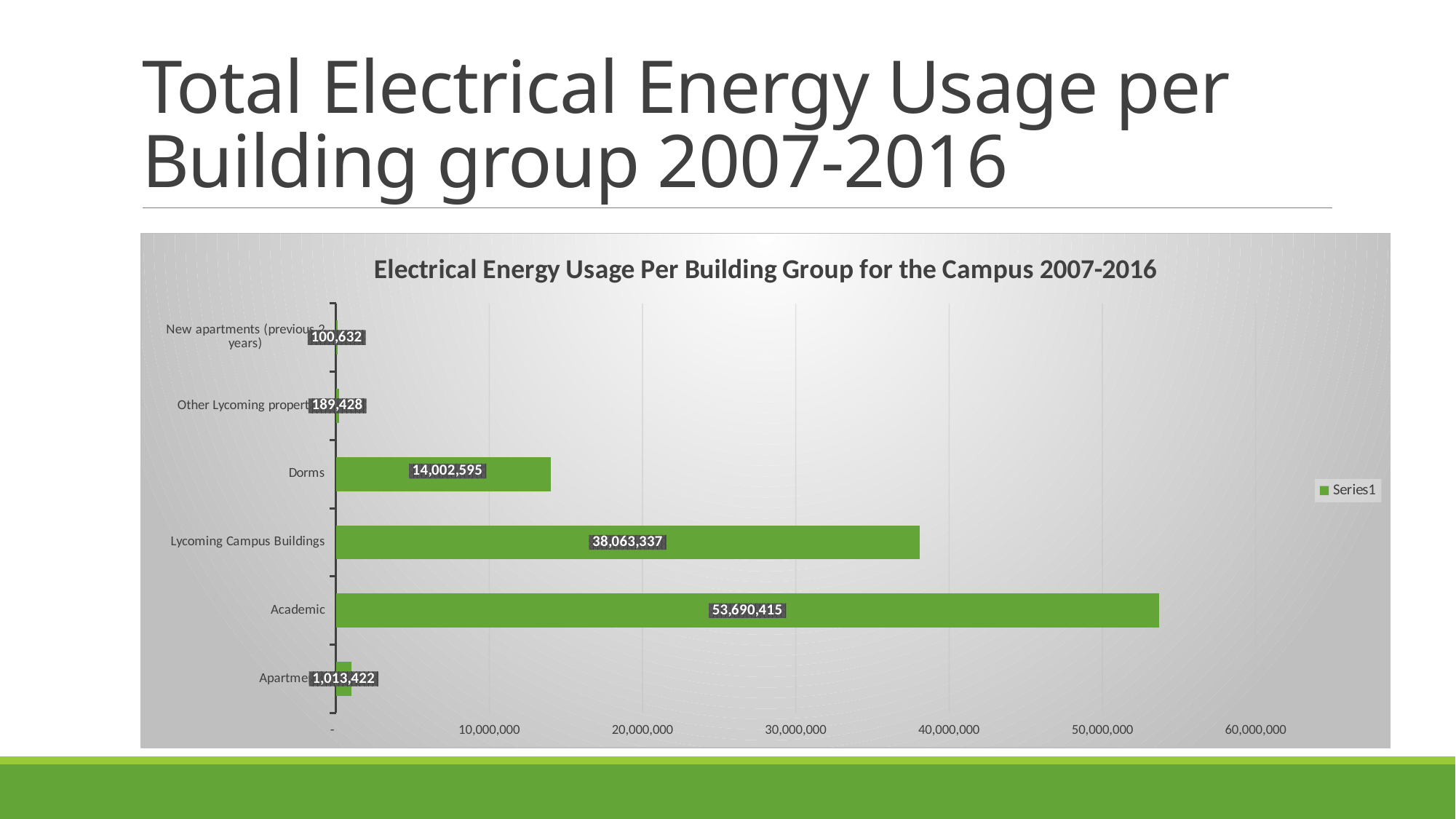
What is the title of the chart? Electrical Energy Usage Per Building Group for the Campus 2007-2016 What is the electrical energy usage value for Lycoming Campus Buildings? 38,063,337 What is the electrical energy usage value for Academic? 53,690,415 What is the electrical energy usage value for Dorms? 14,002,595 What is the difference in electrical energy usage between Lycoming Campus Buildings and Dorms? 24,060,742 What type of chart is shown on the slide? Bar chart Which has higher electrical energy usage, Dorms or Lycoming Campus Buildings? Lycoming Campus Buildings What is the difference in electrical energy usage between Academic and Lycoming Campus Buildings? 15,627,078 How many building groups are shown in the chart? 6 Which building group has the lowest electrical energy usage? New apartments (previous 2 years) What is the electrical energy usage value for New apartments (previous 2 years)? 100,632 Which building group has the highest electrical energy usage? Academic